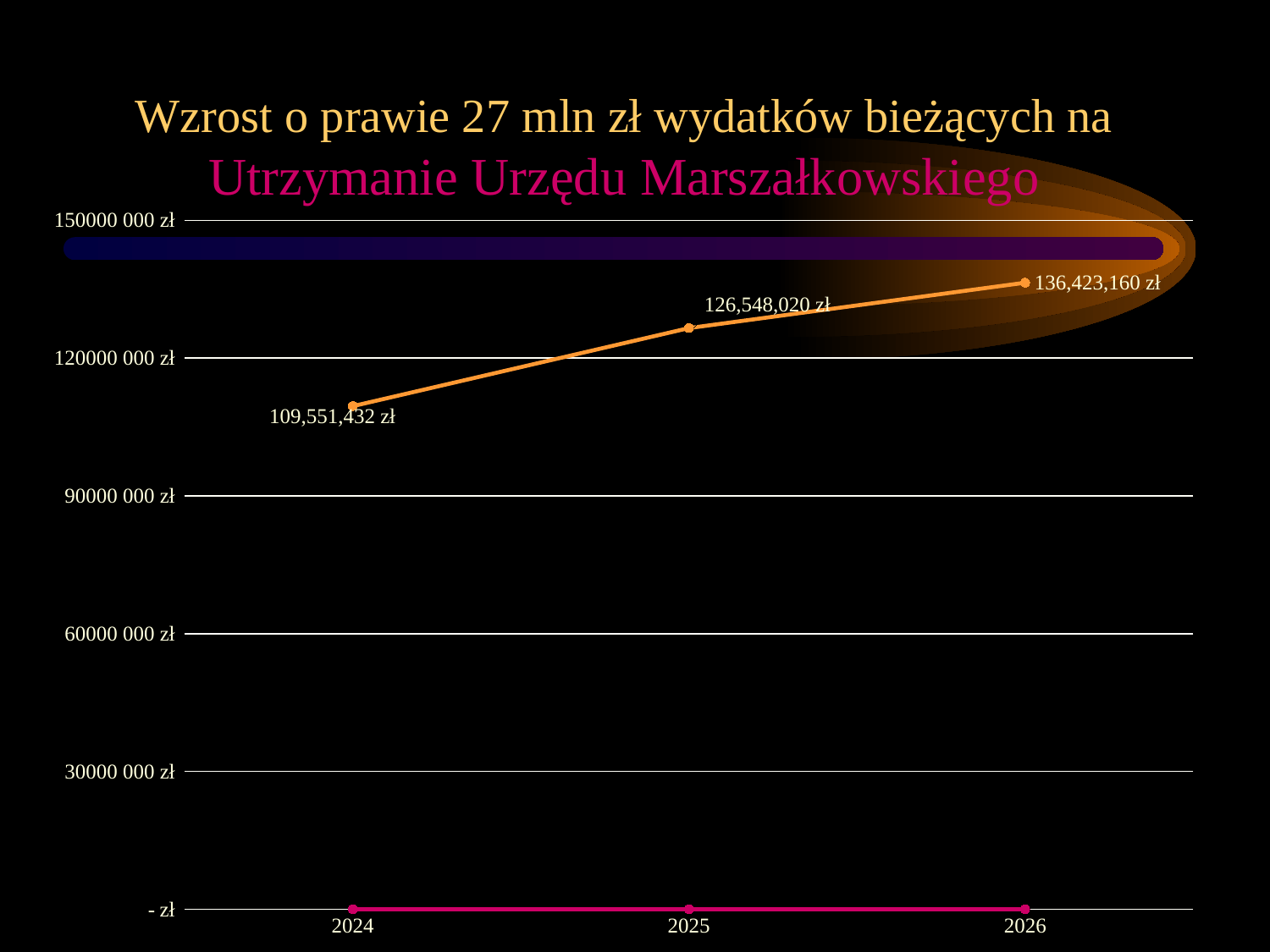
Which is larger, the value for 2025 or the value for 2026? 2026 Which year has the lowest value? 2024 What kind of chart is shown on the slide? line chart What is the value for 2024? 109,551,432 zł What is the difference between the values for 2026 and 2024? 26,871,728 zł Do the values rise or fall from 2024 to 2026? rise What is the value for 2026? 136,423,160 zł What is the difference between the values for 2025 and 2024? 16,996,588 zł Which year has the highest value? 2026 What is the value for 2025? 126,548,020 zł How many years are plotted on the chart? 3 Is the value for 2024 greater or less than 120000 000 zł? less